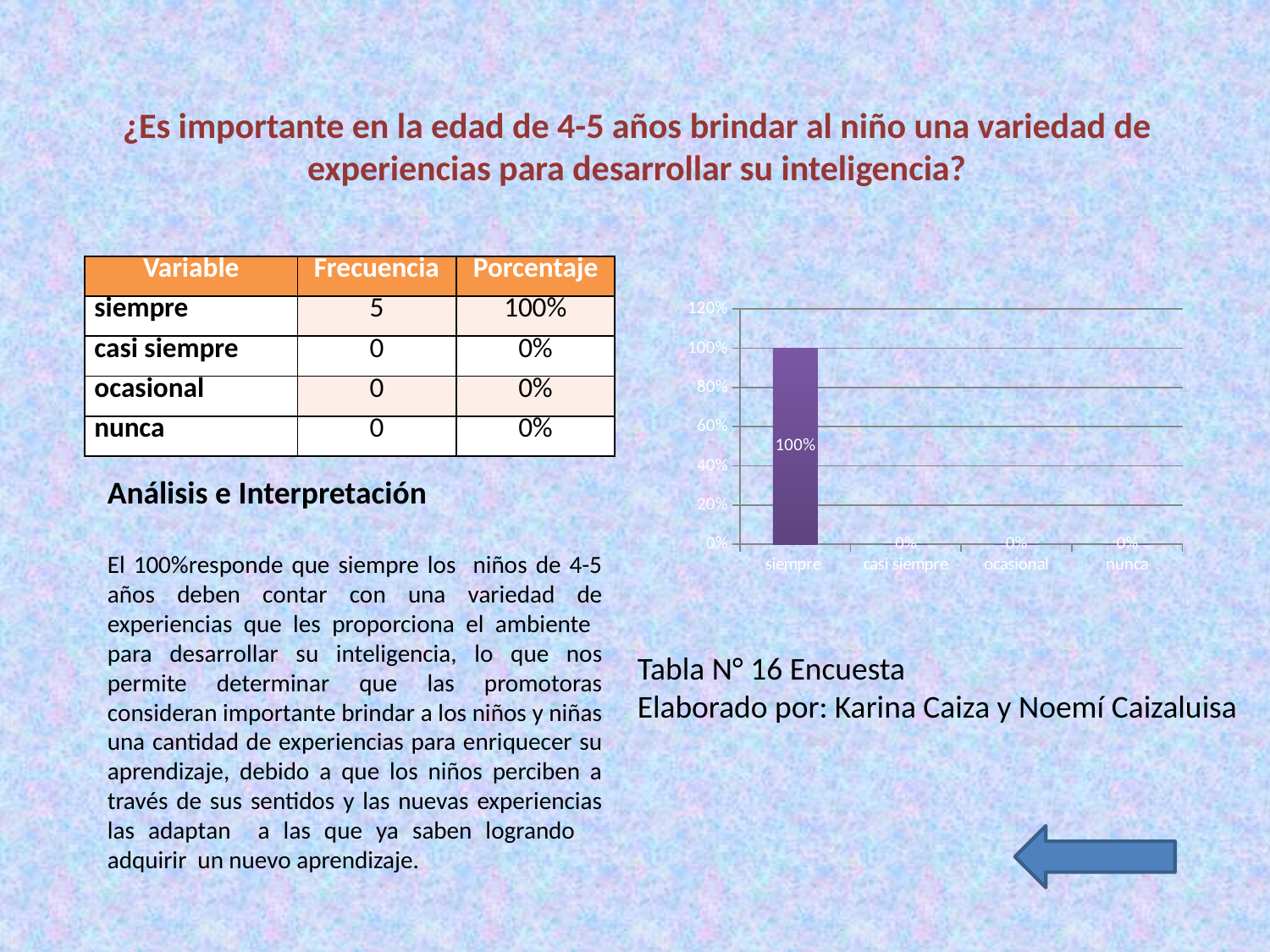
Is the value for siempre greater or less than 80%? greater How many categories are shown on the x axis of the chart? 4 What kind of chart is shown on the slide? bar chart What is the value for siempre in the chart? 100% What is the value for ocasional in the chart? 0% What is the value for nunca in the chart? 0% Which is larger, the value for siempre or the value for ocasional? siempre Which category has the highest value in the chart? siempre What is the value for casi siempre in the chart? 0% What is the highest tick value shown on the y axis of the chart? 120% What colour is the bar for siempre? purple What is the difference between the values for siempre and nunca? 100%